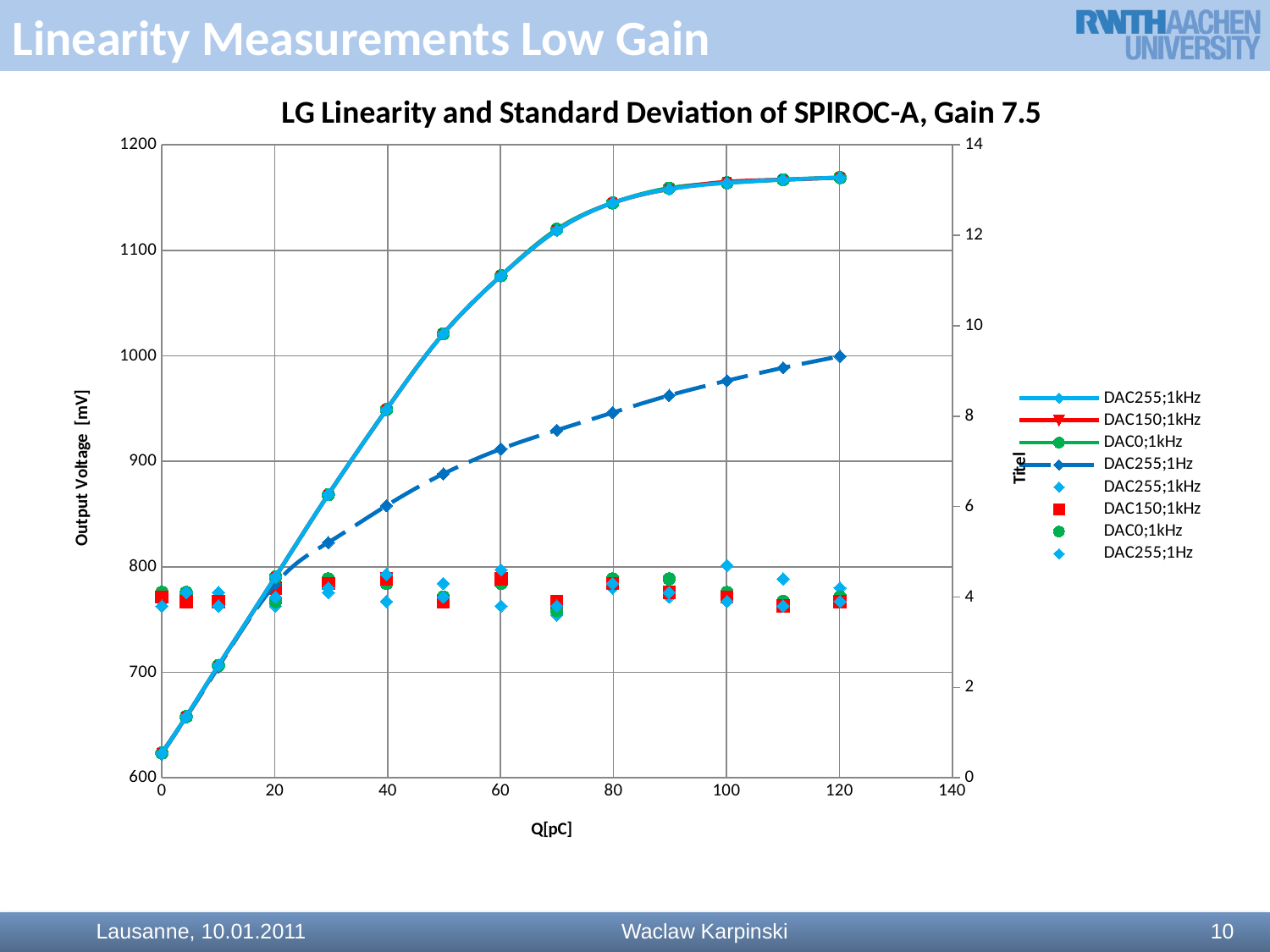
Does the DAC255;1kHz line rise or fall as Q increases from 0 to 120? rise Is the value of the DAC255;1kHz line at Q = 40 greater or less than 900? greater Is the value of the DAC255;1kHz line at Q = 120 greater or less than 1100? greater What is the title of the chart? LG Linearity and Standard Deviation of SPIROC-A, Gain 7.5 Is the value of the DAC255;1kHz line at Q = 60 greater or less than 1000? greater At Q = 100, which line is higher: DAC255;1kHz or DAC255;1Hz? DAC255;1kHz What kind of chart is shown on the slide? line chart How many series does the legend list? 8 What is the label of the x axis? Q[pC]